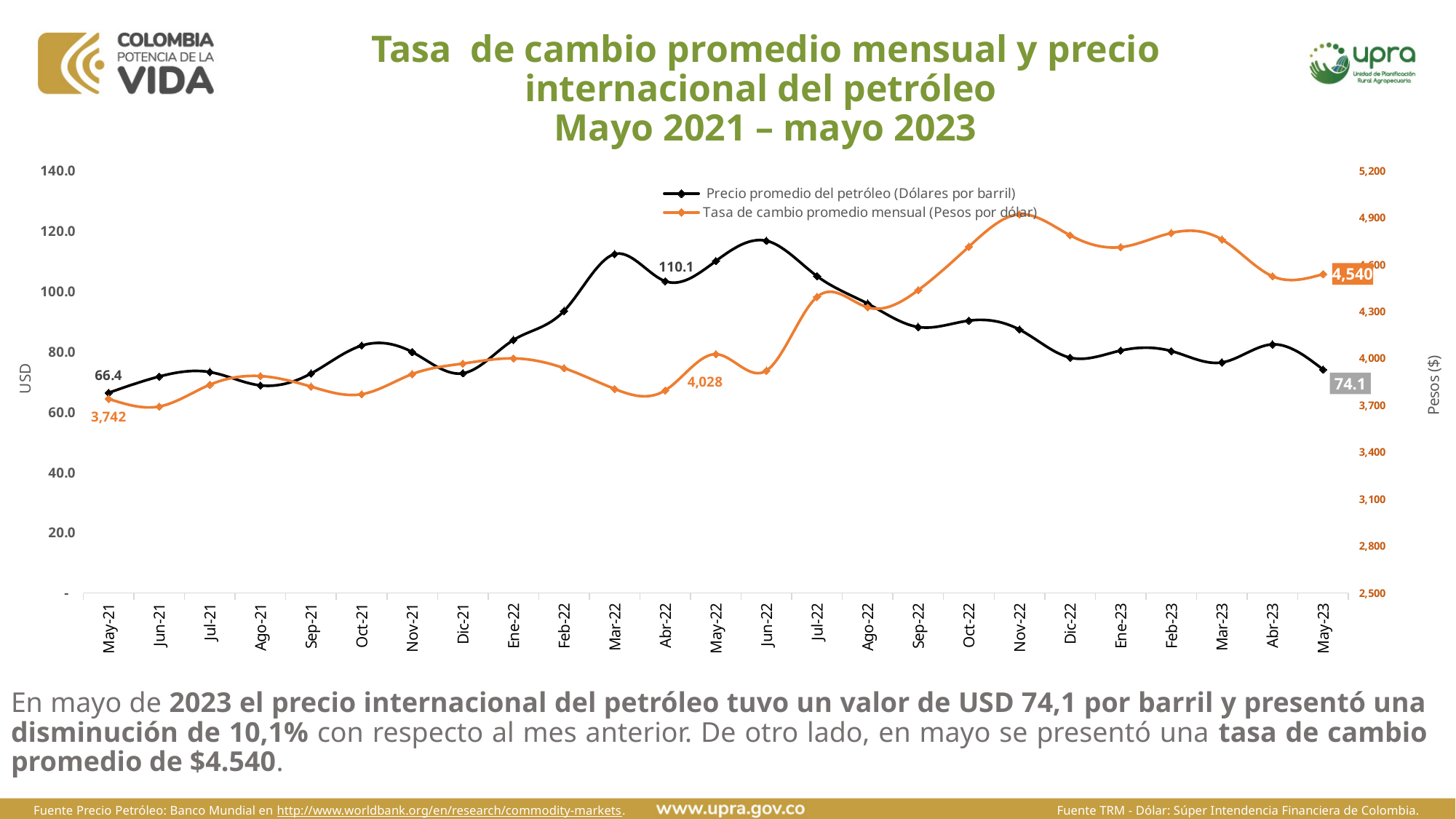
What was the average oil price in May-23? 74.1 By how much did the average exchange rate in May-23 exceed that of May-21? 798 How many series does the legend list? 2 What was the average monthly exchange rate (Tasa de cambio) in May-21? 3,742 In which month did the exchange rate series reach its highest value? Nov-22 How many months are plotted along the x axis? 25 What type of chart is shown on the slide? Line chart What was the average oil price (Precio promedio del petróleo) in May-21? 66.4 What was the average monthly exchange rate in May-23? 4,540 Is the oil price in Jun-22 greater or less than 100? greater